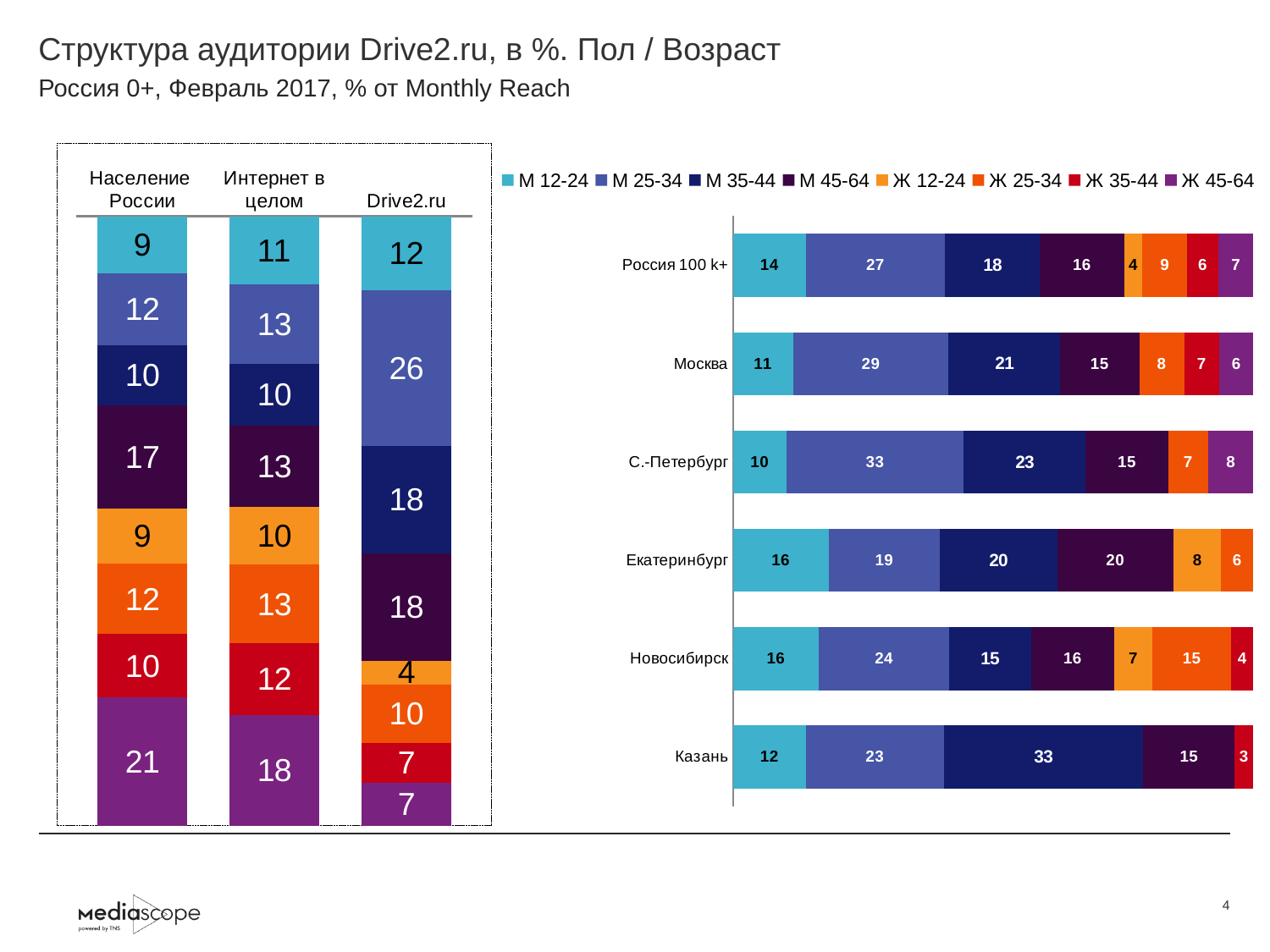
In the left chart, what is the value of М 25-34 for Drive2.ru? 26 How many series does the legend list? 8 What type of chart is the right chart? Stacked bar chart In the right chart, what is the difference between М 25-34 for Москва and М 25-34 for Екатеринбург? 10 In the left chart, what is the value of Ж 45-64 for Население России? 21 In the right chart, what is the value of М 35-44 for Казань? 33 In the right chart, what is the value of М 25-34 for С.-Петербург? 33 In the left chart, which segment of the Drive2.ru bar is the smallest? Ж 12-24 In the right chart, which city has the highest value for М 25-34? С.-Петербург In the left chart, what is the total of the Население России bar? 100 In the left chart, which is larger: М 45-64 for Население России or М 45-64 for Интернет в целом? Население России How many cities/regions are shown in the right chart? 6